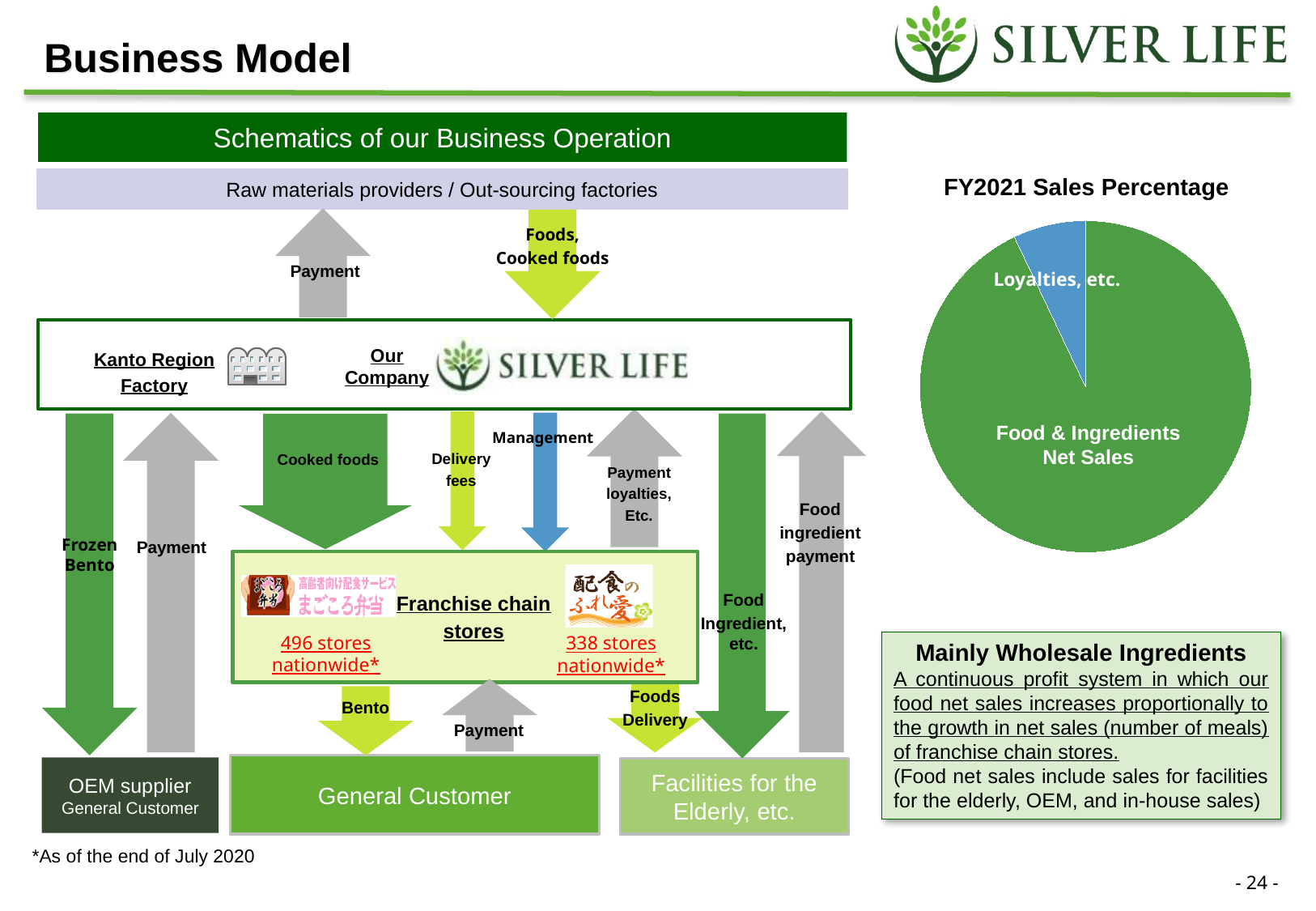
What kind of chart is shown under the title "FY2021 Sales Percentage"? Pie chart Which slice of the FY2021 Sales Percentage pie chart is the smallest? Loyalties, etc. Which slice of the FY2021 Sales Percentage pie chart is the largest? Food & Ingredients Net Sales Does the Food & Ingredients Net Sales slice make up more or less than half of the FY2021 Sales Percentage pie chart? More How many slices does the FY2021 Sales Percentage pie chart have? 2 In the FY2021 Sales Percentage pie chart, which is larger: Food & Ingredients Net Sales or Loyalties, etc.? Food & Ingredients Net Sales What colour is the Loyalties, etc. slice in the FY2021 Sales Percentage pie chart? Blue What is the title of the pie chart on the slide? FY2021 Sales Percentage